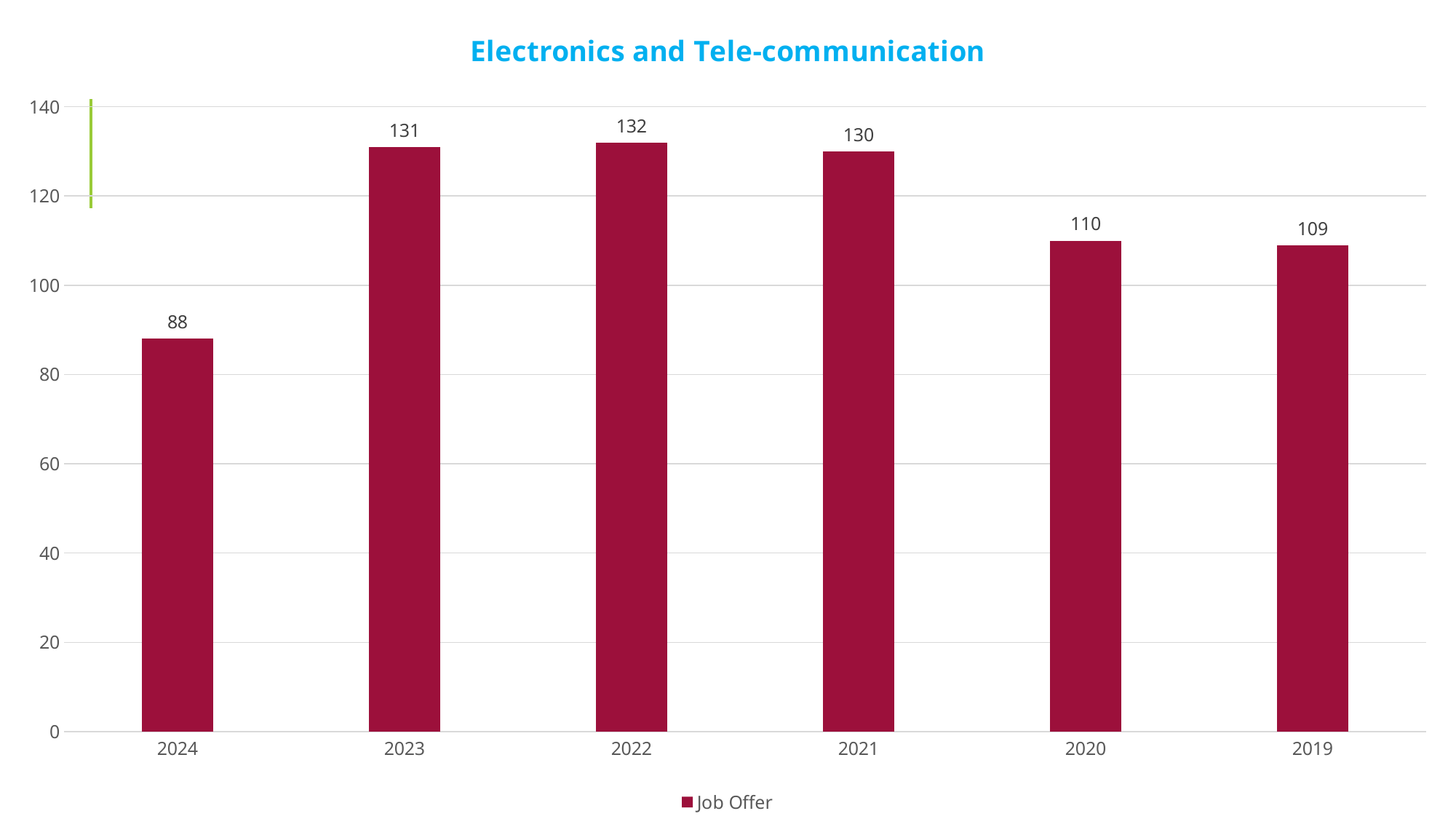
What is the Job Offer value for 2019? 109 Is the Job Offer value for 2020 greater or less than 100? greater What is the Job Offer value for 2021? 130 Which year has the lowest Job Offer value? 2024 What kind of chart is shown on the slide? bar chart How many years are shown on the x axis? 6 What is the Job Offer value for 2024? 88 Which year has the highest Job Offer value? 2022 What is the difference between the Job Offer values for 2020 and 2019? 1 How many series does the legend list? 1 Which is larger, the Job Offer value for 2021 or for 2020? 2021 What is the difference between the Job Offer values for 2023 and 2024? 43